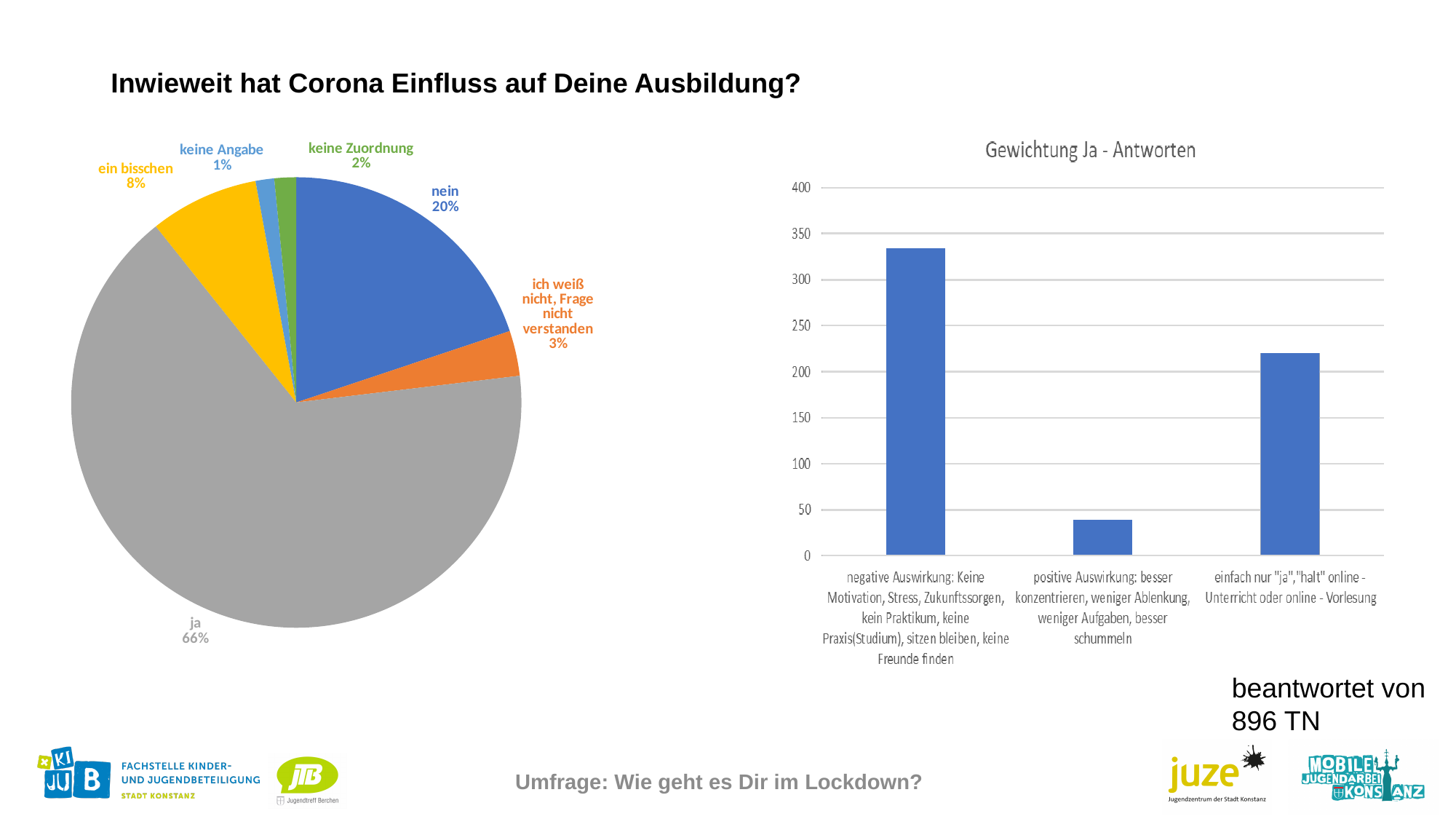
In the pie chart on the left, which category has the largest share? ja In the pie chart on the left, what share of responses is "nein"? 20% How many slices does the pie chart on the left have? 6 What type of chart is the chart titled "Gewichtung Ja - Antworten"? bar chart In the chart "Gewichtung Ja - Antworten", which category has the highest bar? negative Auswirkung In the pie chart on the left, what share of responses is "ein bisschen"? 8% In the chart "Gewichtung Ja - Antworten", is the value for "negative Auswirkung" greater or less than 300? greater In the pie chart on the left, what share of responses is "ja"? 66% In the chart "Gewichtung Ja - Antworten", is the value for "positive Auswirkung" greater or less than 50? less In the pie chart on the left, how many percentage points larger is "ja" than "nein"? 46 In the pie chart on the left, which is larger: "ein bisschen" or "ich weiß nicht, Frage nicht verstanden"? ein bisschen In the pie chart on the left, which category has the smallest share? keine Angabe